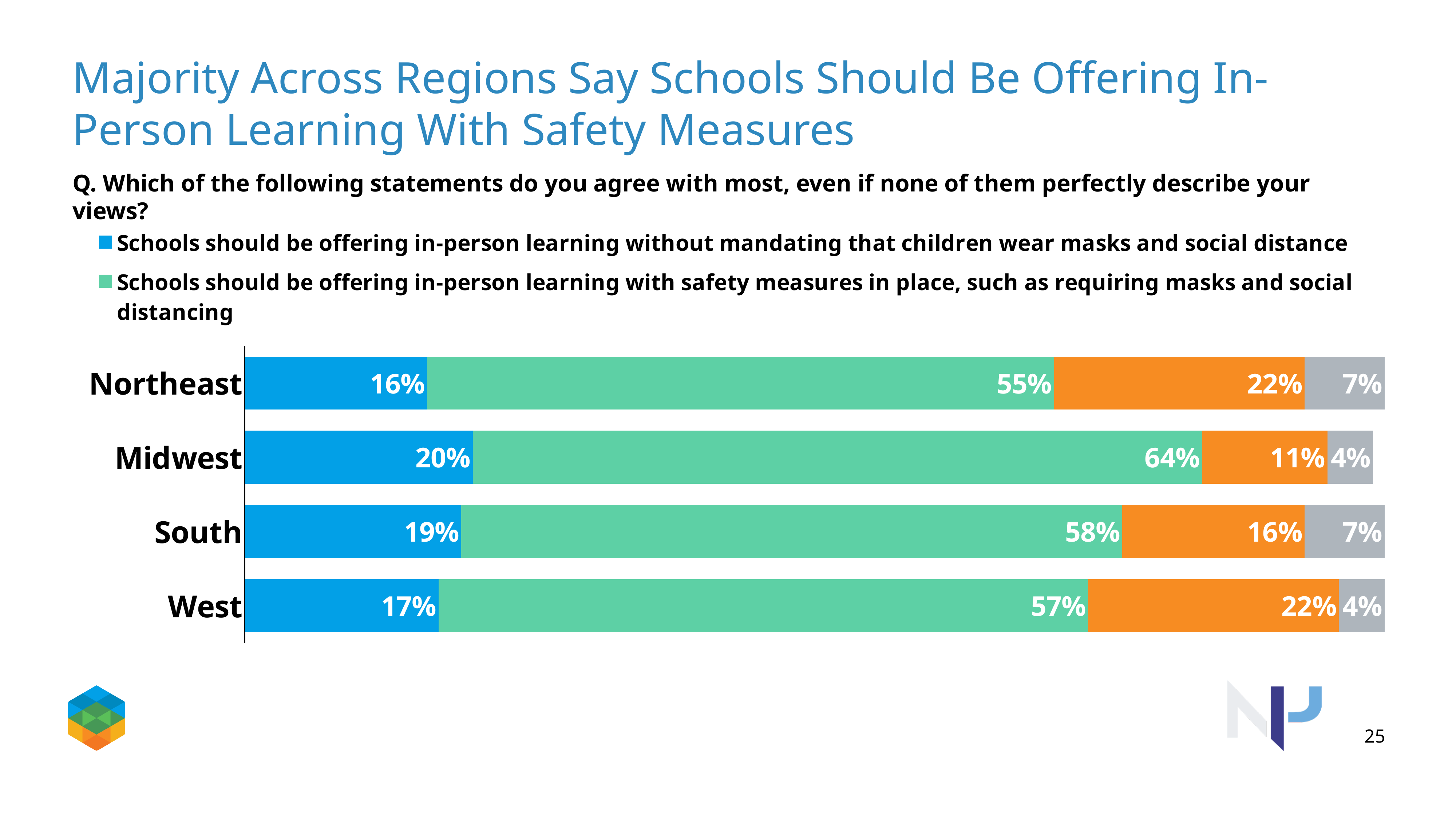
What type of chart is shown on the slide? Stacked bar chart How many series does the legend list? 2 What is the value of the orange segment for the West? 22% What is the difference between the Midwest and Northeast shares saying schools should offer in-person learning with safety measures in place? 9 percentage points What percentage of respondents in the Midwest say schools should be offering in-person learning with safety measures in place? 64% What percentage of respondents in the Northeast say schools should be offering in-person learning without mandating masks and social distancing? 16% What is the total of all segments in the Midwest bar? 99% Which region has the highest share saying schools should offer in-person learning with safety measures in place? Midwest How many regions are shown in the chart? 4 Which is larger: the share in the South or the share in the West saying schools should offer in-person learning without mandating masks and social distancing? South Which region has the lowest share saying schools should offer in-person learning with safety measures in place? Northeast What colour represents the statement that schools should offer in-person learning with safety measures in place? Green